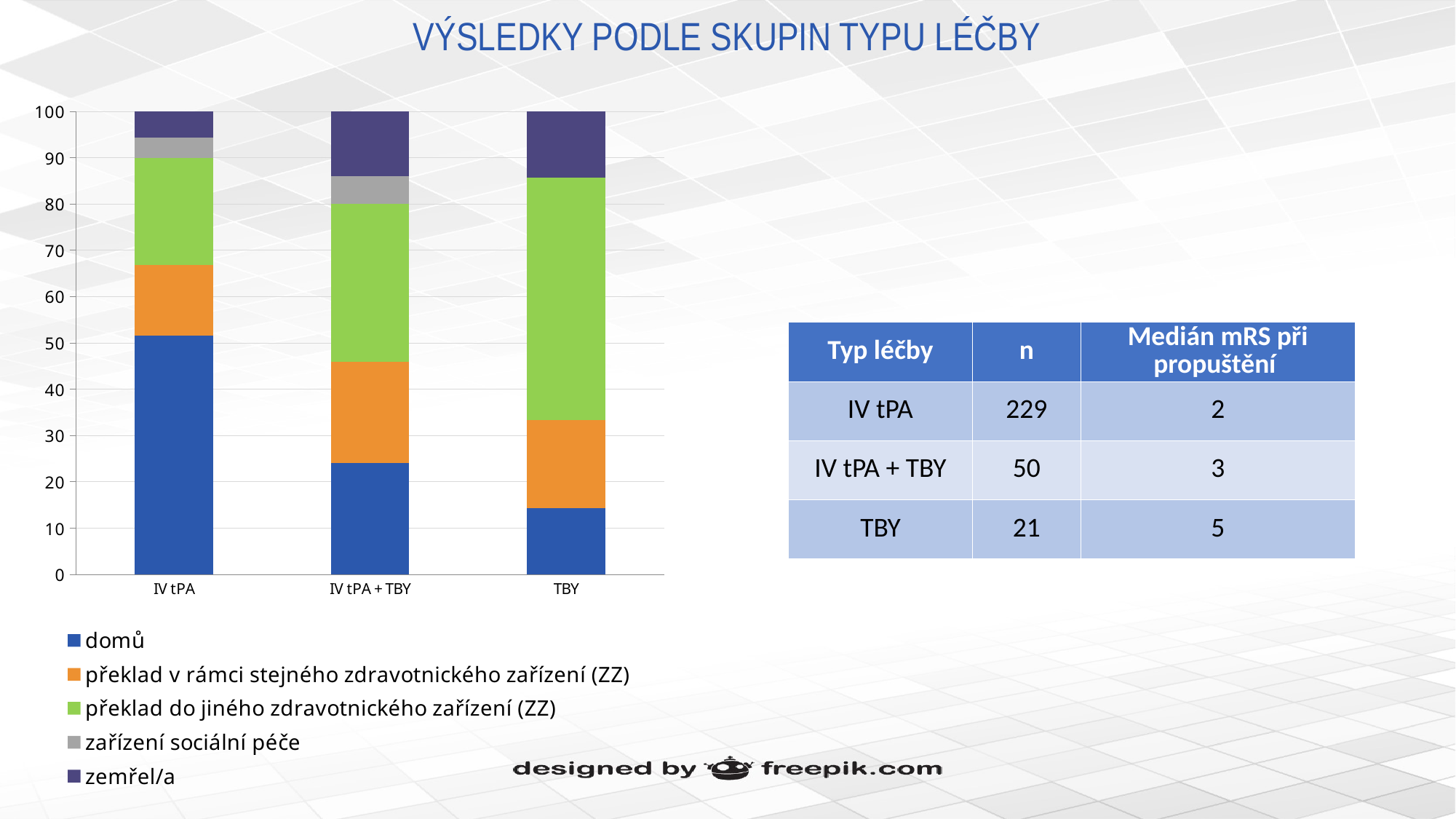
Is the value of the 'domů' segment for IV tPA greater or less than 40? greater What kind of chart is shown on the slide? stacked bar chart Which legend entry is shown in dark blue at the bottom of each stacked bar? domů Which is larger: the 'domů' segment for IV tPA or for TBY? IV tPA Which treatment group has the largest 'domů' segment? IV tPA Is the value of the 'domů' segment for IV tPA + TBY greater or less than 30? less Which treatment group has the smallest 'domů' segment? TBY Is the value of the 'zemřel/a' segment for IV tPA greater or less than 10? less How many treatment groups (categories) are shown on the x axis of the chart? 3 How many series does the chart legend list? 5 What is the title of the slide containing the chart? VÝSLEDKY PODLE SKUPIN TYPU LÉČBY